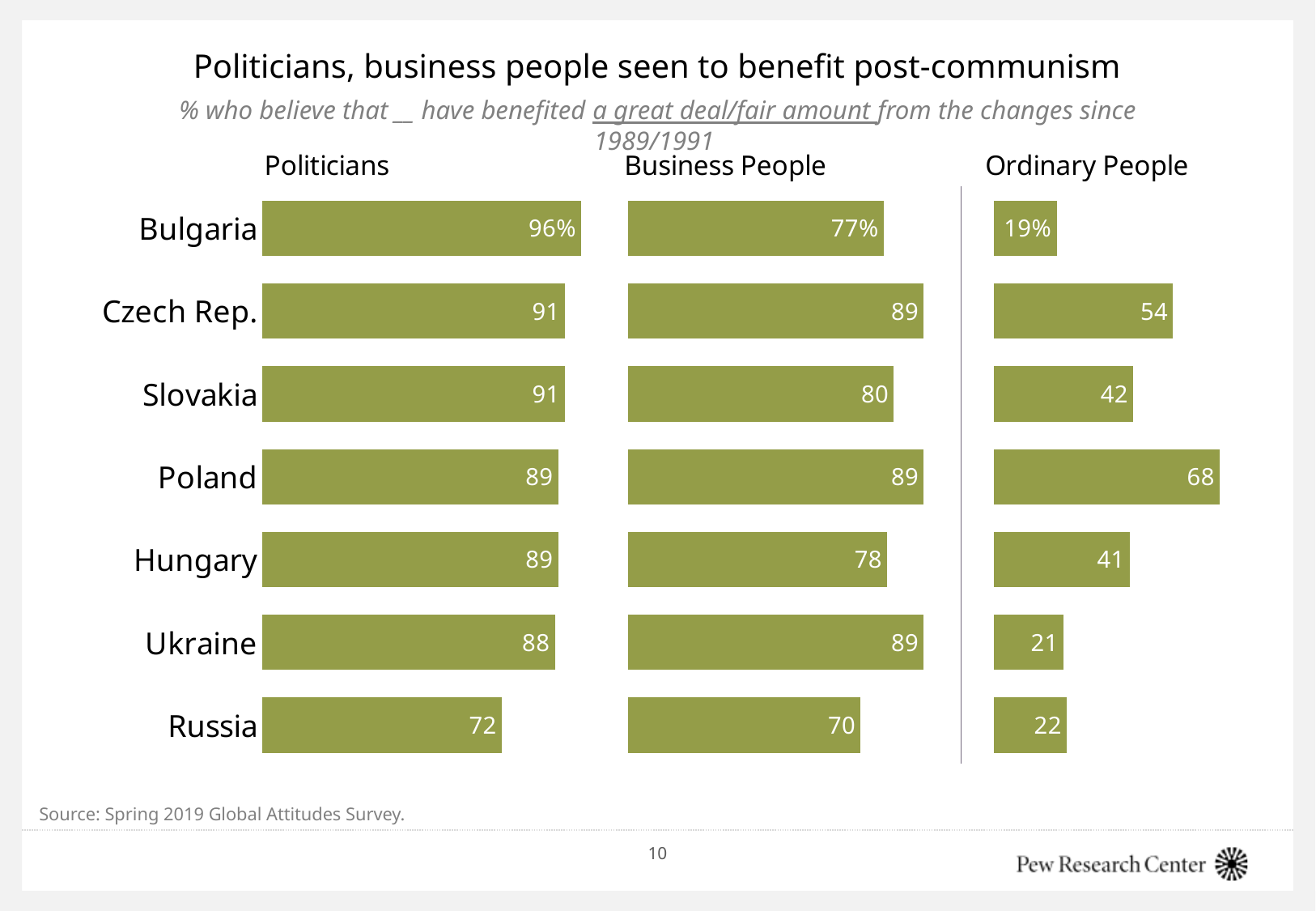
What is the source cited at the bottom of the slide? Spring 2019 Global Attitudes Survey In the Politicians panel, which country has the highest value? Bulgaria In the Politicians panel, what percentage of people in Bulgaria believe politicians have benefited a great deal/fair amount? 96% What is the difference between the Politicians value and the Ordinary People value for Bulgaria? 77 In the Ordinary People panel, what is the value for Poland? 68 In the Business People panel, what is the value for Russia? 70 In the Ordinary People panel, which country has the highest value? Poland What kind of chart is used on this slide? Bar chart In the Ordinary People panel, which country has the lowest value? Bulgaria How many countries are shown on the slide? 7 For Hungary, which is larger: the Business People value or the Ordinary People value? Business People In the Politicians panel, which country has the lowest value? Russia